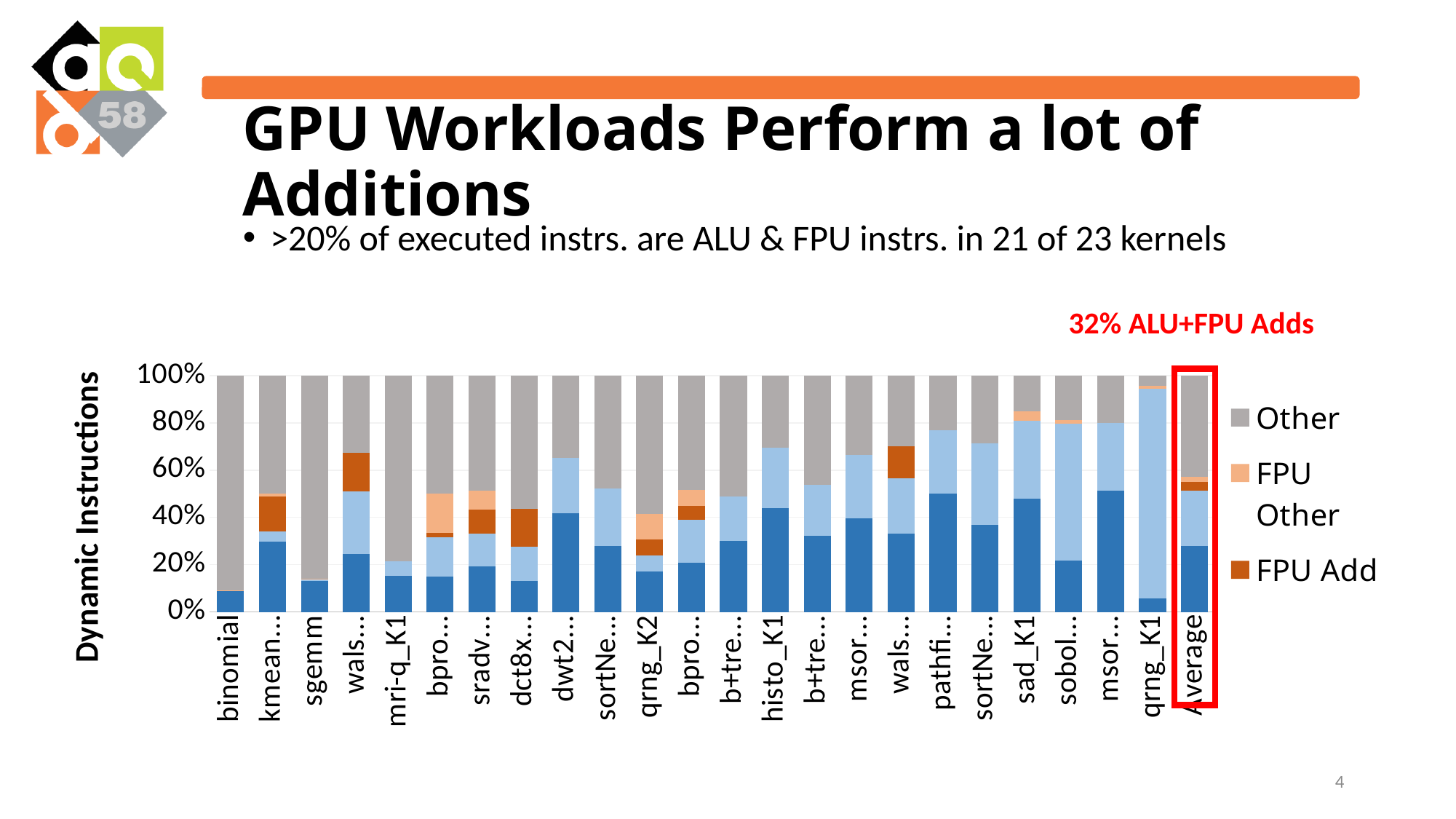
Is the dark blue bottom segment for sgemm greater or less than 20%? less What is the maximum value shown on the vertical axis? 100% According to the annotation above the chart, what share of the Average bar is ALU+FPU Adds? 32% What kind of chart is shown on the slide? Stacked bar chart Does the top of the light blue segment for qrng_K1 reach greater or less than 80%? greater Is the dark blue bottom segment for histo_K1 greater or less than 40%? greater What is the label on the vertical axis of the chart? Dynamic Instructions How many bars are plotted in the chart, including the Average bar? 24 Which bar in the chart is highlighted with a red box? Average Which bar has the larger dark blue bottom segment, kmean... or sgemm? kmean... Which bar has the larger gray 'Other' segment, binomial or qrng_K1? binomial